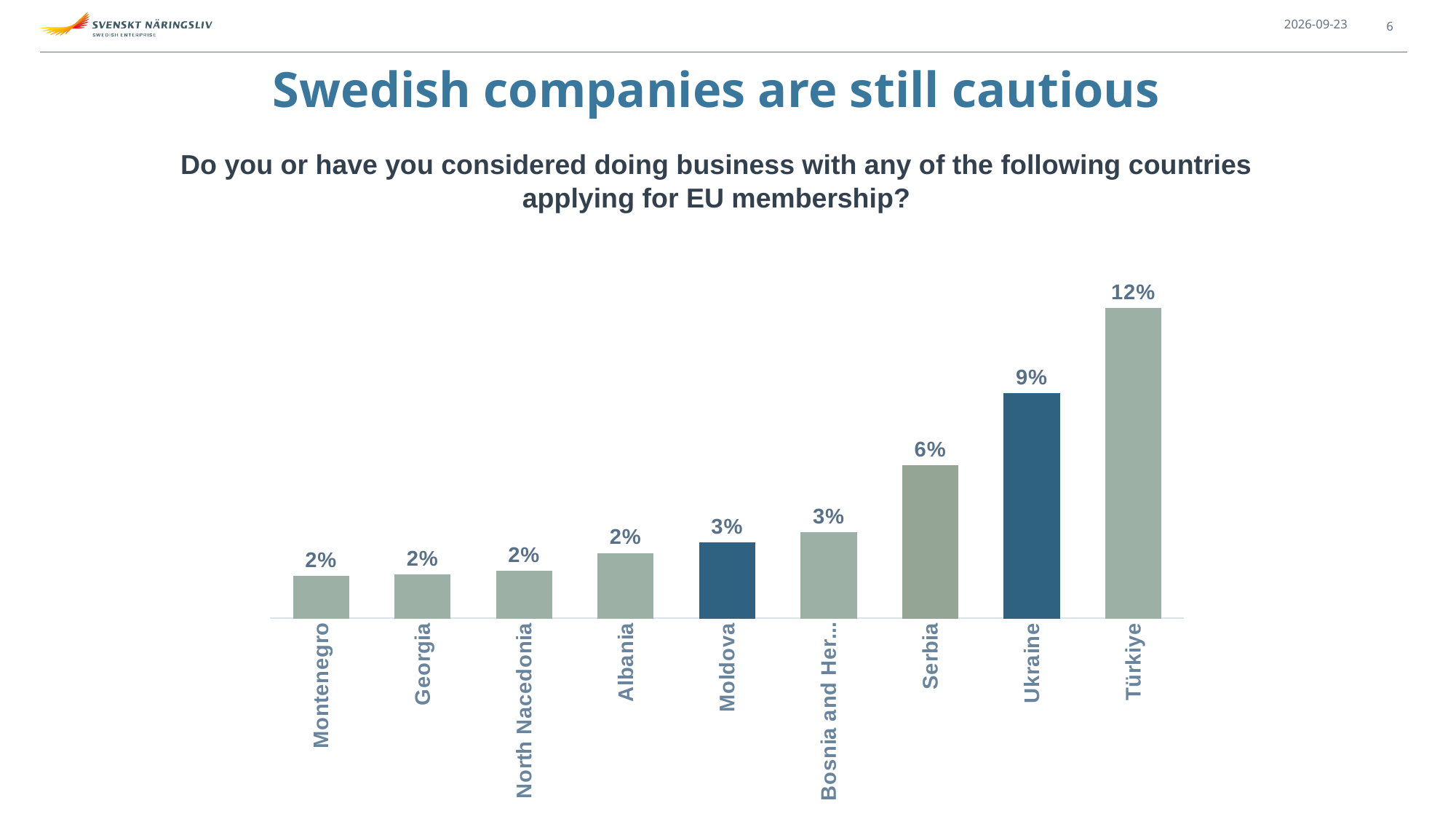
What is the value for Moldova? 3% How many countries are shown in the chart? 9 What is the value for Albania? 2% Which is larger, the value for Ukraine or the value for Serbia? Ukraine Do the values rise or fall from left to right along the x axis? Rise What is the value for Serbia? 6% What is the difference between the values for Türkiye and Ukraine? 3% Which country has the highest value? Türkiye What kind of chart is shown on the slide? Bar chart What is the value for Türkiye? 12% What is the value for Ukraine? 9% What is the difference between the values for Serbia and Moldova? 3%